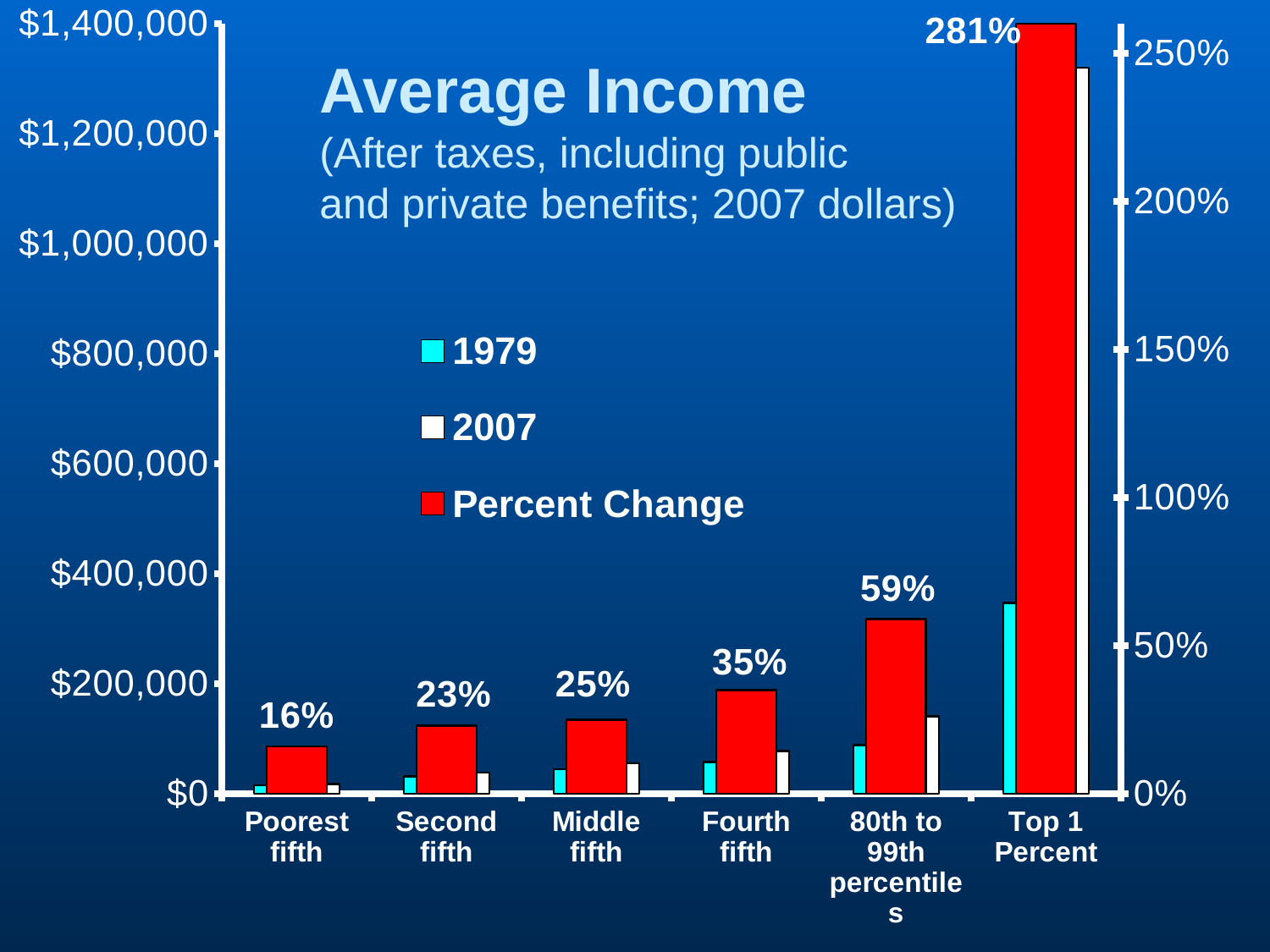
What is the Percent Change for the 80th to 99th percentiles? 59% What is the Percent Change for the Poorest fifth? 16% Does the Percent Change rise or fall moving from the Poorest fifth to the Top 1 Percent along the x axis? rise What is the difference in Percent Change between the Top 1 Percent and the 80th to 99th percentiles? 222% What is the Percent Change for the Top 1 Percent? 281% Which category has the highest Percent Change? Top 1 Percent What is the difference in Percent Change between the Fourth fifth and the Middle fifth? 10% Which category has the lowest Percent Change? Poorest fifth Is the 1979 average income for the Top 1 Percent greater or less than $200,000? greater Which has a larger Percent Change, the Second fifth or the Fourth fifth? Fourth fifth Is the 2007 average income for the Top 1 Percent greater or less than $1,200,000? greater How many series does the legend list? 3